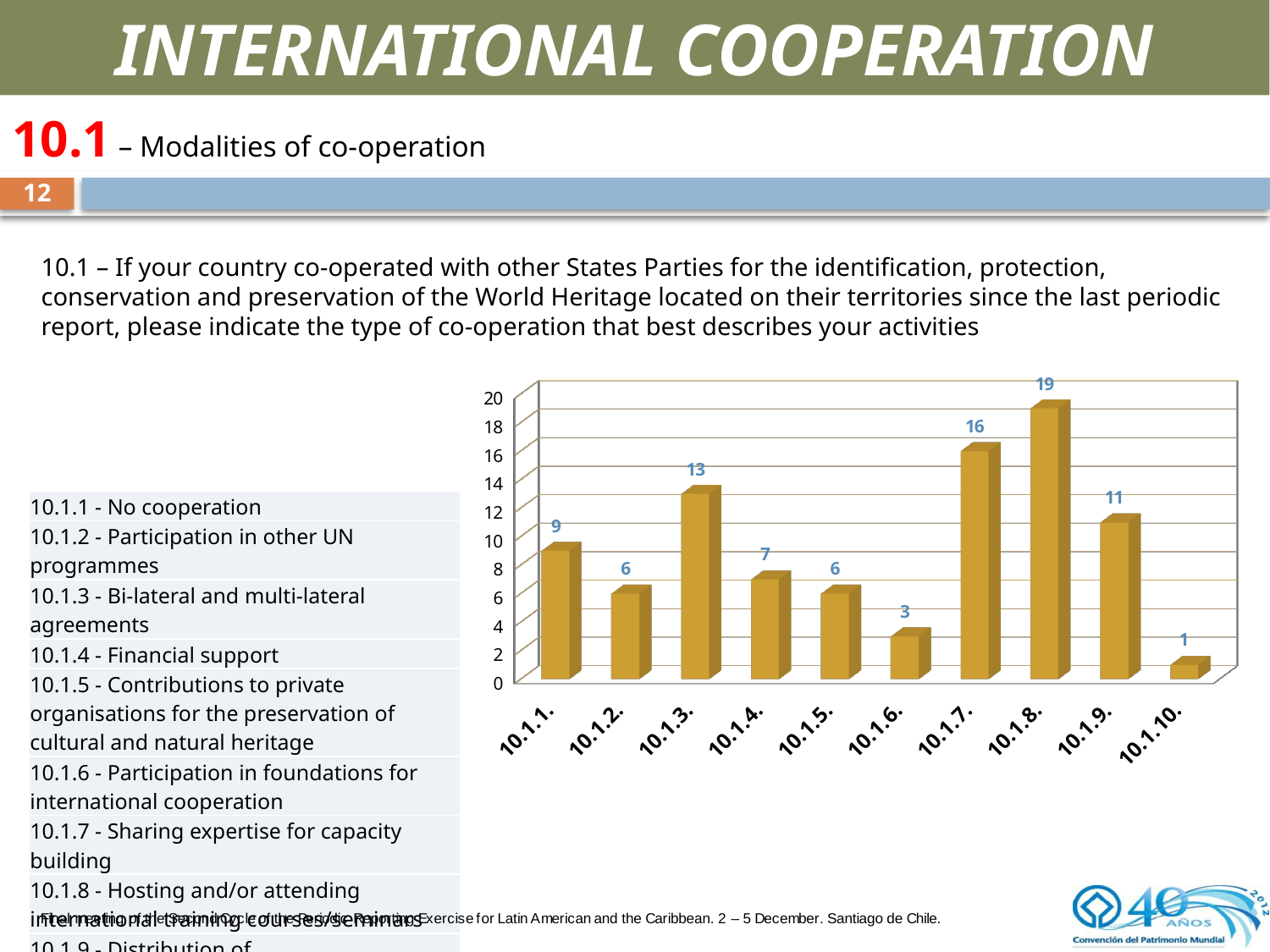
What is the maximum value shown on the y axis? 20 What is the value for category 10.1.8.? 19 How many categories are shown on the x axis? 10 What kind of chart is shown on the slide? bar chart What is the value for category 10.1.10.? 1 What is the difference between the values for 10.1.8. and 10.1.10.? 18 Is the value for 10.1.9. greater or less than 10? greater What is the difference between the values for 10.1.7. and 10.1.6.? 13 Which is larger, the value for 10.1.1. or the value for 10.1.4.? 10.1.1. What is the value for category 10.1.3.? 13 Which category has the highest value? 10.1.8. Which category has the lowest value? 10.1.10.